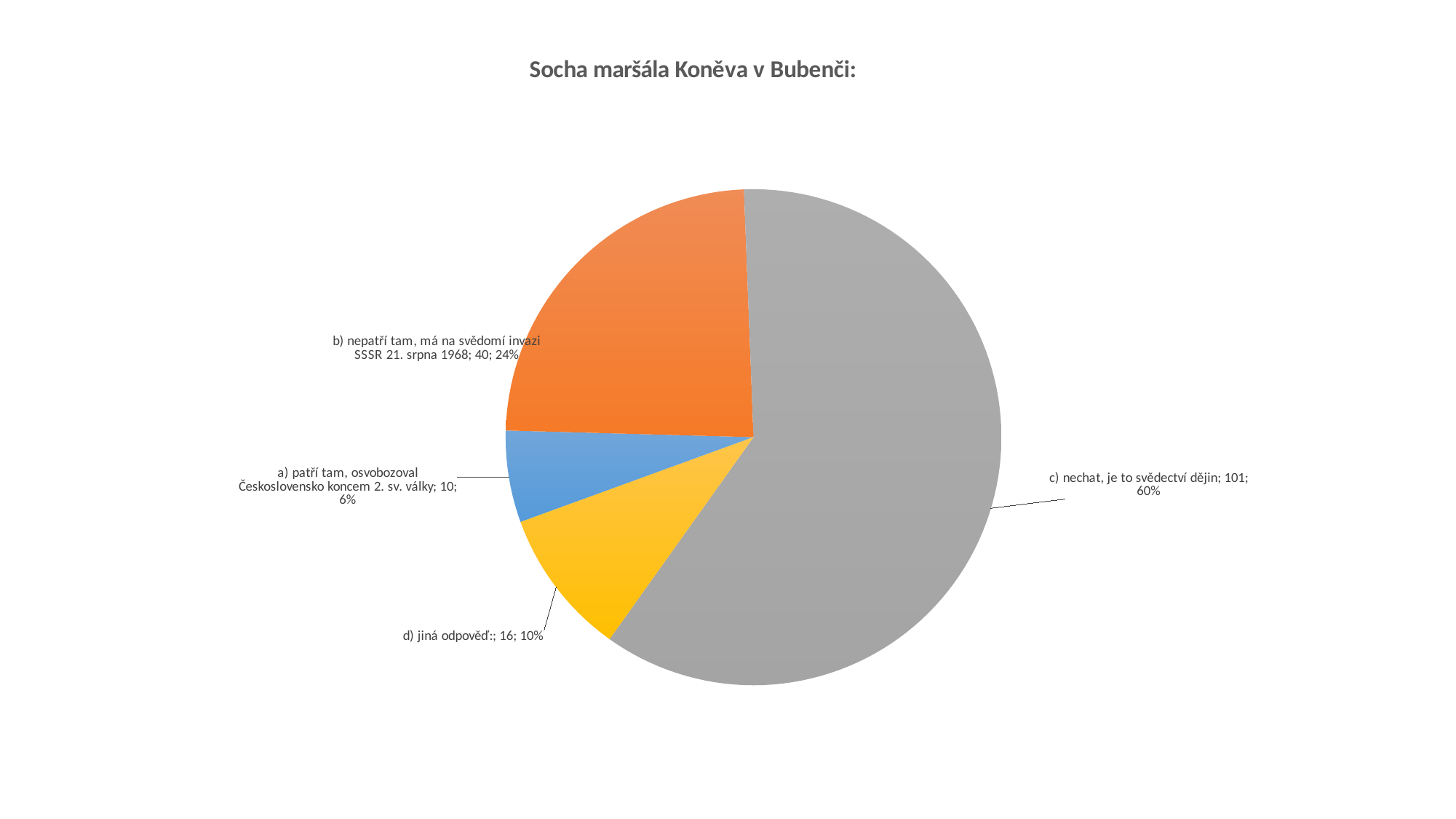
What is the value for 'd) jiná odpověď'? 16 What share of the pie does 'a) patří tam, osvobozoval Československo koncem 2. sv. války' represent? 6% What is the difference between the values for 'c) nechat, je to svědectví dějin' and 'b) nepatří tam, má na svědomí invazi SSSR 21. srpna 1968'? 61 What share of the pie does 'c) nechat, je to svědectví dějin' represent? 60% What is the value for 'a) patří tam, osvobozoval Československo koncem 2. sv. války'? 10 How many slices does the pie chart have? 4 What is the value for 'b) nepatří tam, má na svědomí invazi SSSR 21. srpna 1968'? 40 What kind of chart is shown on the slide? pie chart Which category has the largest slice? c) nechat, je to svědectví dějin What is the value for 'c) nechat, je to svědectví dějin'? 101 What is the title of the chart? Socha maršála Koněva v Bubenči: Which category has the smallest slice? a) patří tam, osvobozoval Československo koncem 2. sv. války